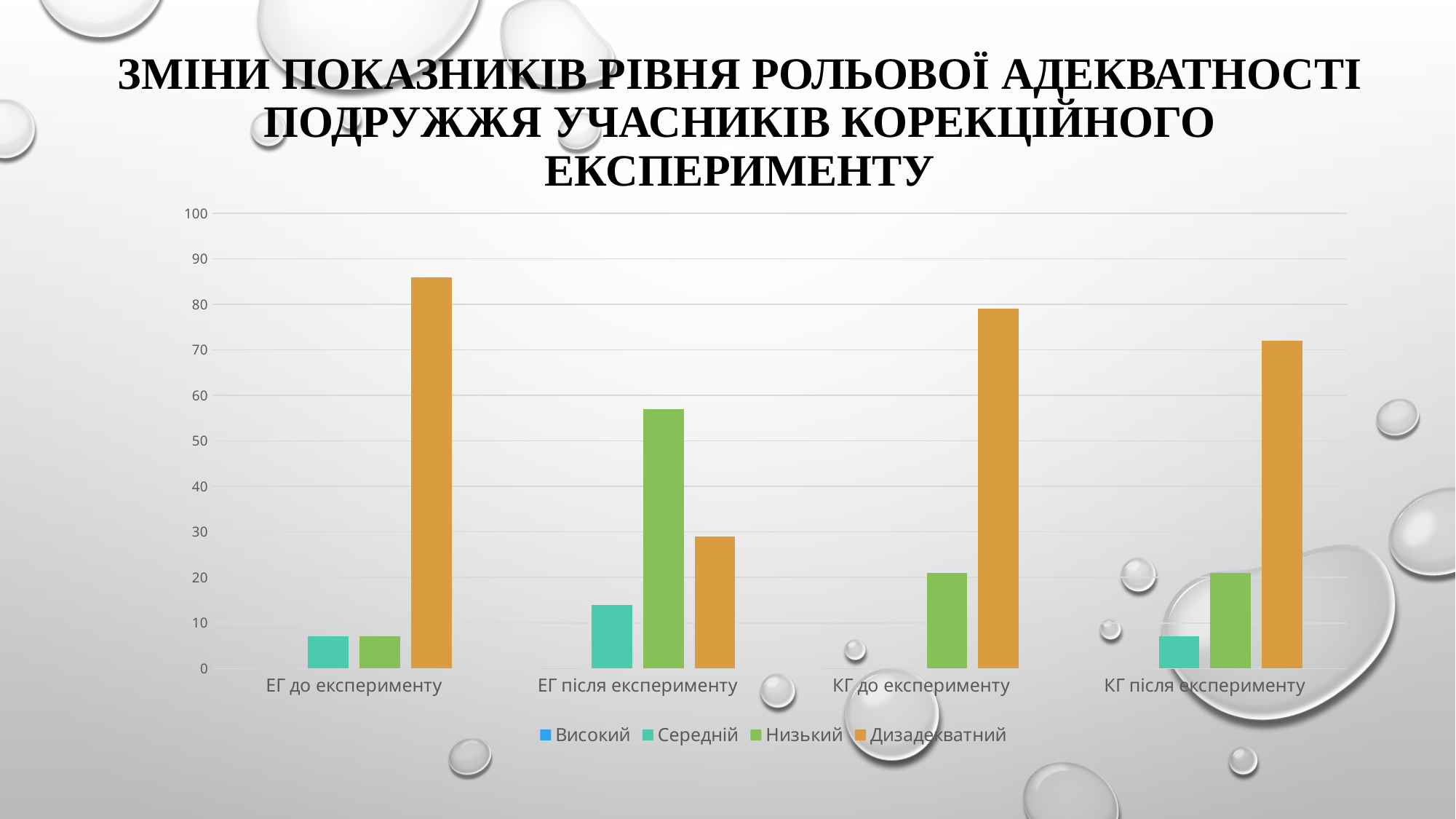
Which category has the lowest Дизадекватний bar? ЕГ після експерименту Does the Дизадекватний value for the ЕГ group rise or fall from before to after the experiment? fall Is the Середній value for ЕГ після експерименту greater or less than 10? greater What kind of chart is shown on the slide? bar chart Is the Дизадекватний value for ЕГ до експерименту greater or less than 80? greater How many series does the legend list? 4 Which category has the highest Дизадекватний bar? ЕГ до експерименту How many categories are shown on the x axis of the chart? 4 Is the Низький value for ЕГ після експерименту greater or less than 50? greater Within ЕГ після експерименту, which series has the tallest bar? Низький Which is larger, the Дизадекватний value for КГ до експерименту or for КГ після експерименту? КГ до експерименту